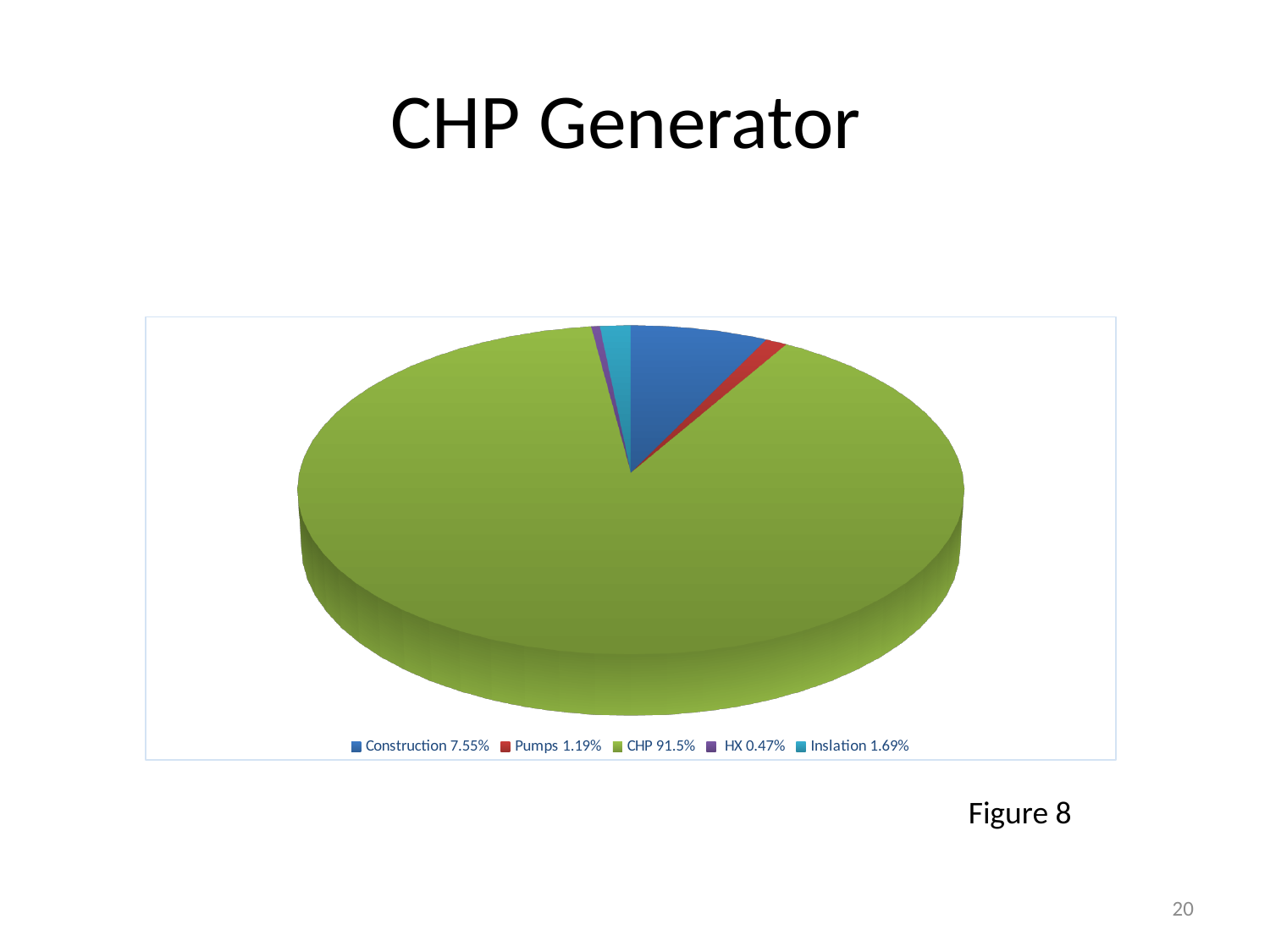
How many slices does the pie chart have? 5 What percentage does the legend give for HX? 0.47% Which category has the smallest share of the pie? HX What percentage does the legend give for CHP? 91.5% What percentage does the legend give for Pumps? 1.19% What is the difference between the Construction share and the Pumps share? 6.36% What percentage does the legend give for Construction? 7.55% What percentage does the legend give for Inslation? 1.69% What is the title of the slide containing the pie chart? CHP Generator Which is larger, the share for Construction or the share for Inslation? Construction Which category has the largest share of the pie? CHP What kind of chart is shown on the slide? Pie chart